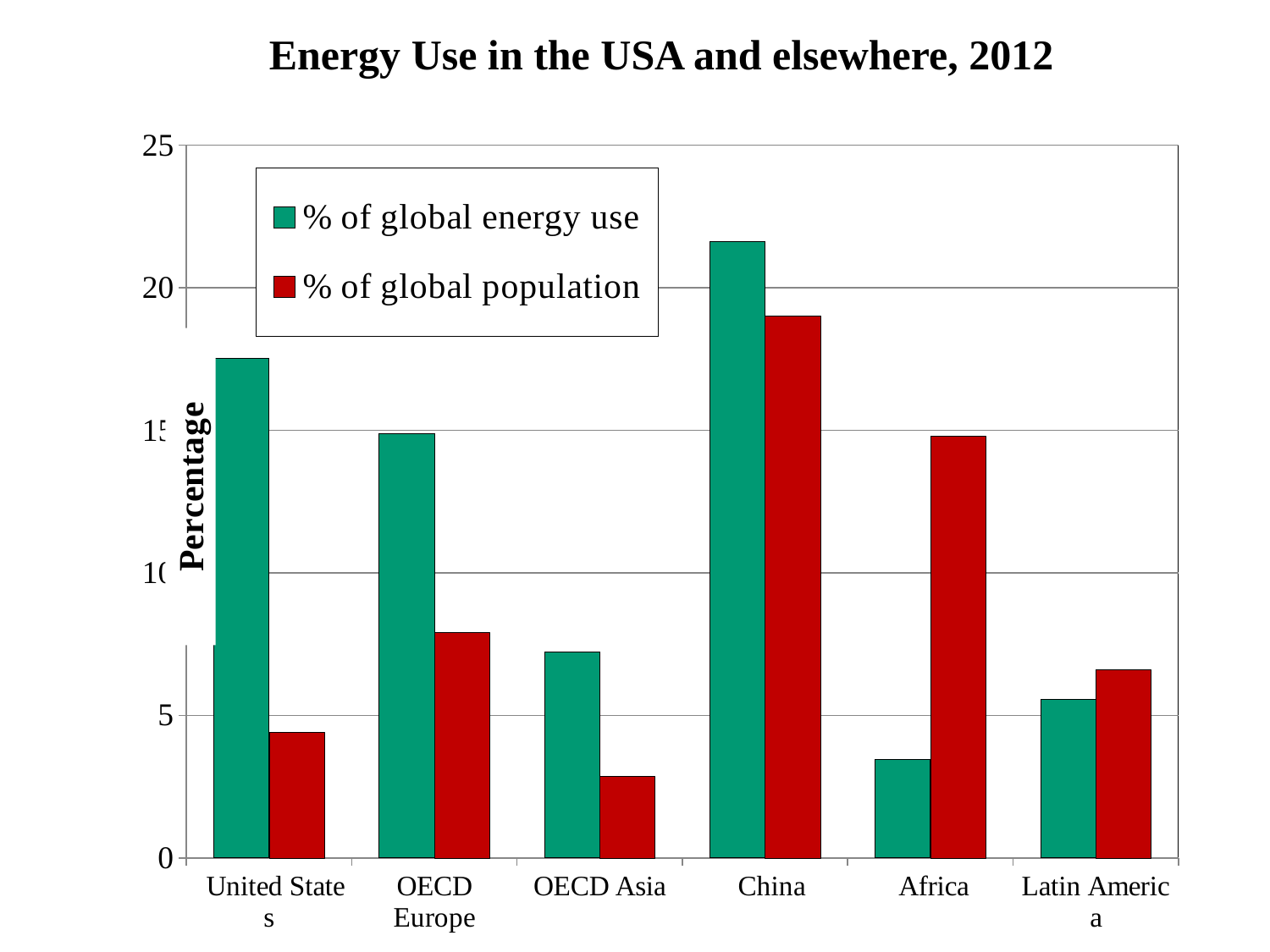
Which region has the lowest % of global energy use? Africa How many categories (regions) are shown on the x axis? 6 For Africa, which is larger: % of global energy use or % of global population? % of global population Is the % of global population for OECD Asia greater or less than 5? less Which region has the highest % of global population? China What is the title of the chart? Energy Use in the USA and elsewhere, 2012 What kind of chart is shown on the slide? bar chart How many series does the legend list? 2 Is the % of global population for Africa greater or less than 10? greater Is the % of global energy use for the United States greater or less than 15? greater Which region has the lowest % of global population? OECD Asia Which region has the highest % of global energy use? China